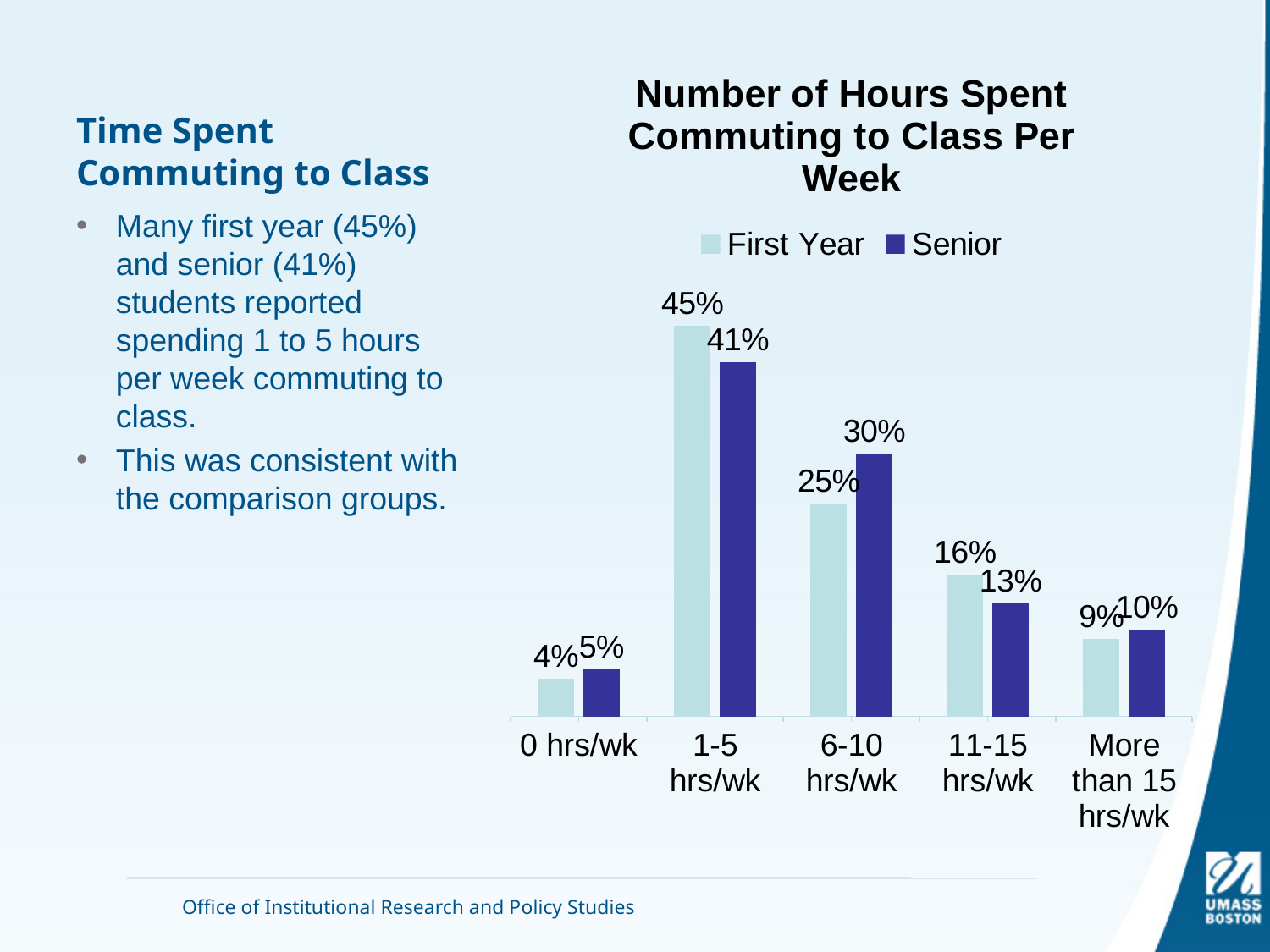
How many categories are shown on the x axis? 5 What is the Senior value for 0 hrs/wk? 5% Which is larger for 11-15 hrs/wk, the First Year value or the Senior value? First Year What is the First Year value for 1-5 hrs/wk? 45% What kind of chart is shown? Bar chart What is the Senior value for 6-10 hrs/wk? 30% What is the difference between the First Year and Senior values for 6-10 hrs/wk? 5% Which category has the highest Senior value? 1-5 hrs/wk What is the First Year value for More than 15 hrs/wk? 9% What is the title of the chart? Number of Hours Spent Commuting to Class Per Week Which category has the lowest First Year value? 0 hrs/wk How many series does the legend list? 2